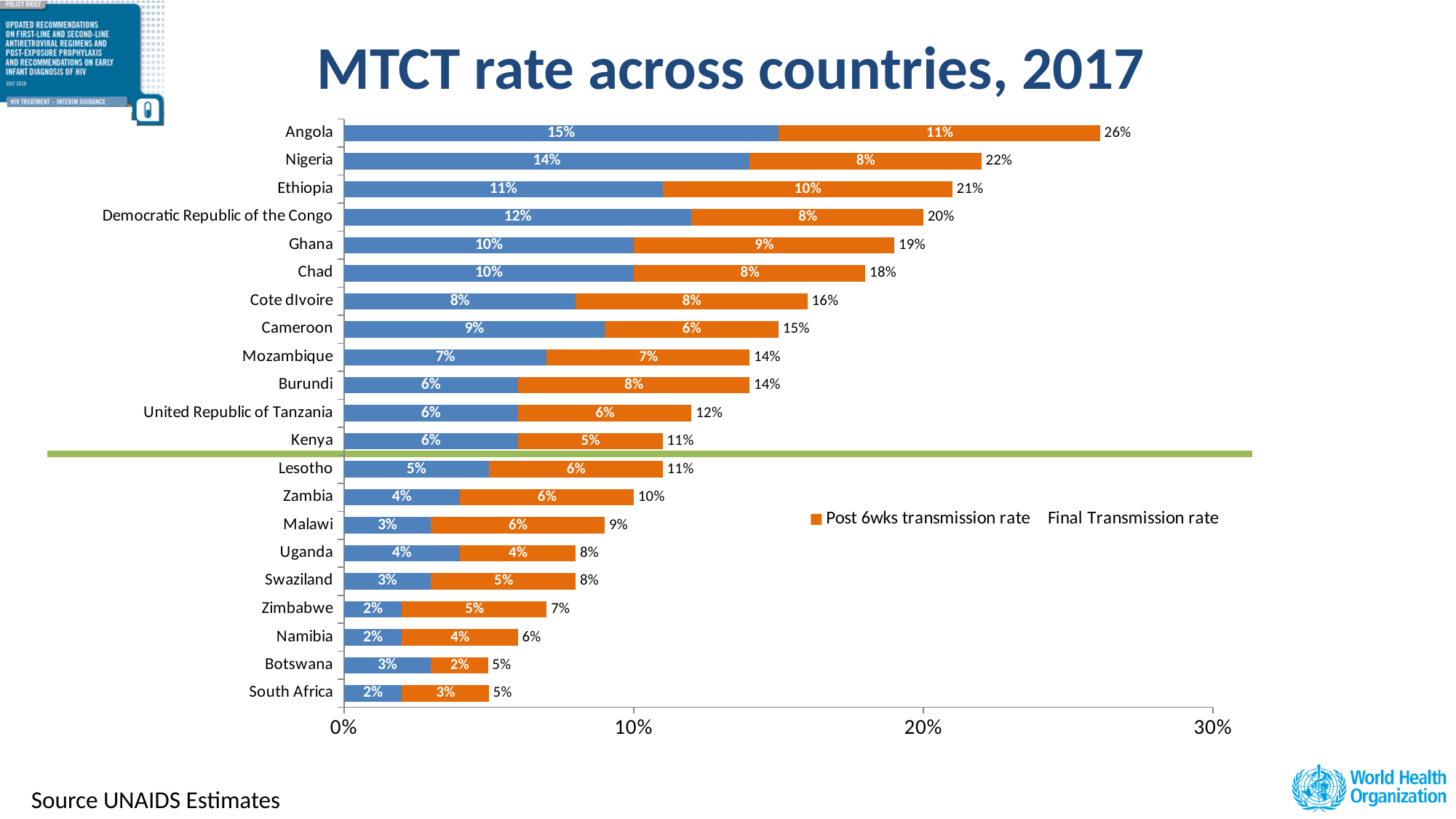
Which legend entry is shown with an orange marker? Post 6wks transmission rate How many countries are listed on the chart? 21 What is the total MTCT rate shown for Mozambique? 14% What kind of chart is shown on the slide? Stacked bar chart Which has the higher total MTCT rate, Ethiopia or the Democratic Republic of the Congo? Ethiopia What is the value of the orange segment for Ethiopia? 10% Which country has the highest total MTCT rate? Angola What is the total MTCT rate shown for Ghana? 19% What is the value of the blue segment for Nigeria? 14% What is the difference between the total rates for Angola and Nigeria? 4 percentage points How many series does the legend list? 2 Is the total MTCT rate for Kenya greater or less than 20%? less